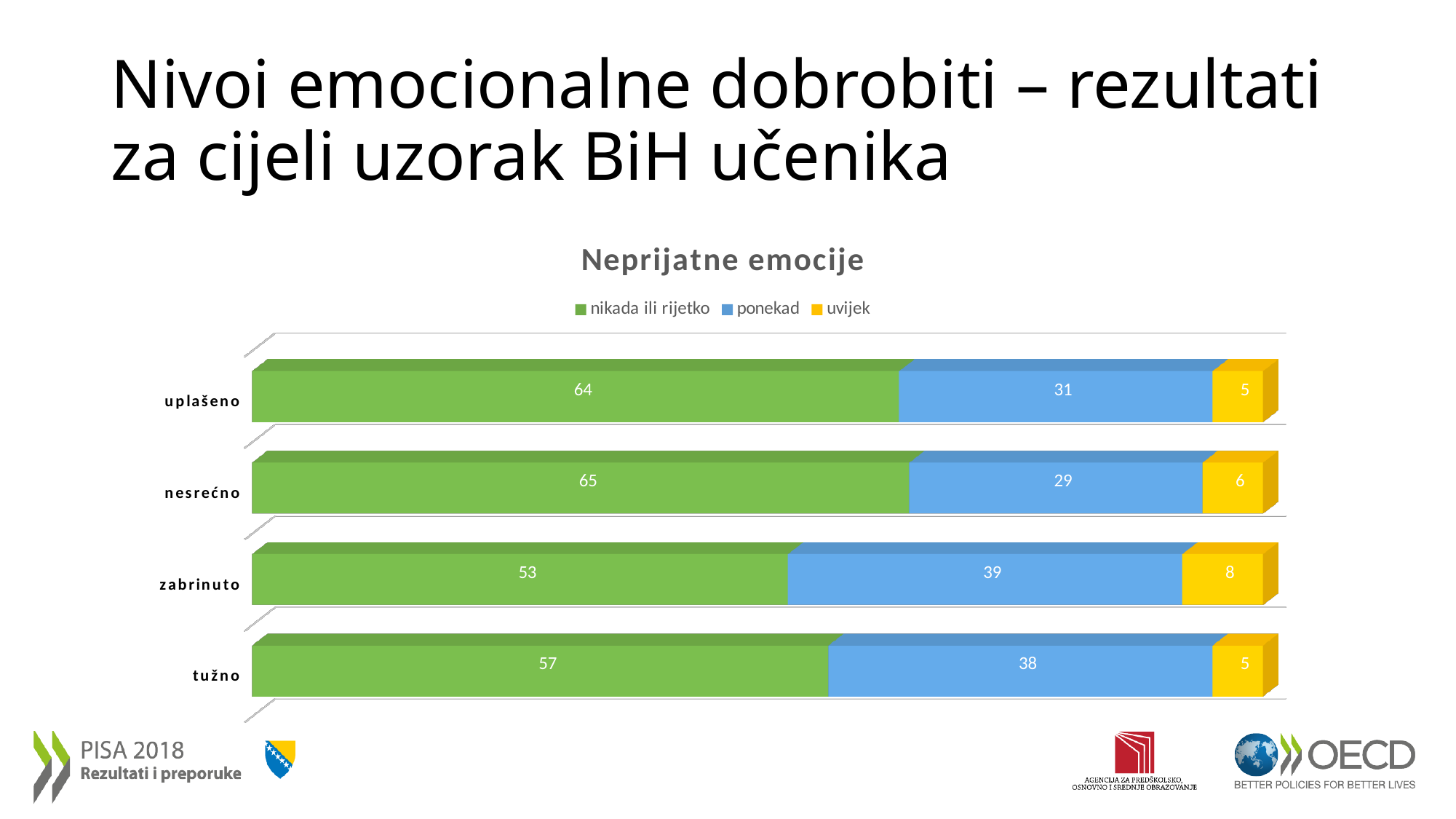
What kind of chart is shown on the slide? stacked bar chart What is the value for 'ponekad' in the 'zabrinuto' category? 39 What is the value for 'uvijek' in the 'nesrećno' category? 6 Which category has the lowest value for 'nikada ili rijetko'? zabrinuto Which category has the highest value for 'uvijek'? zabrinuto What is the difference between the 'ponekad' values for 'tužno' and 'uplašeno'? 7 Which category has the highest value for 'nikada ili rijetko'? nesrećno How many categories are shown on the chart? 4 What is the title of the chart? Neprijatne emocije Which is larger: the 'nikada ili rijetko' value for 'tužno' or for 'zabrinuto'? tužno How many series does the legend list? 3 What is the value for 'nikada ili rijetko' in the 'uplašeno' category? 64